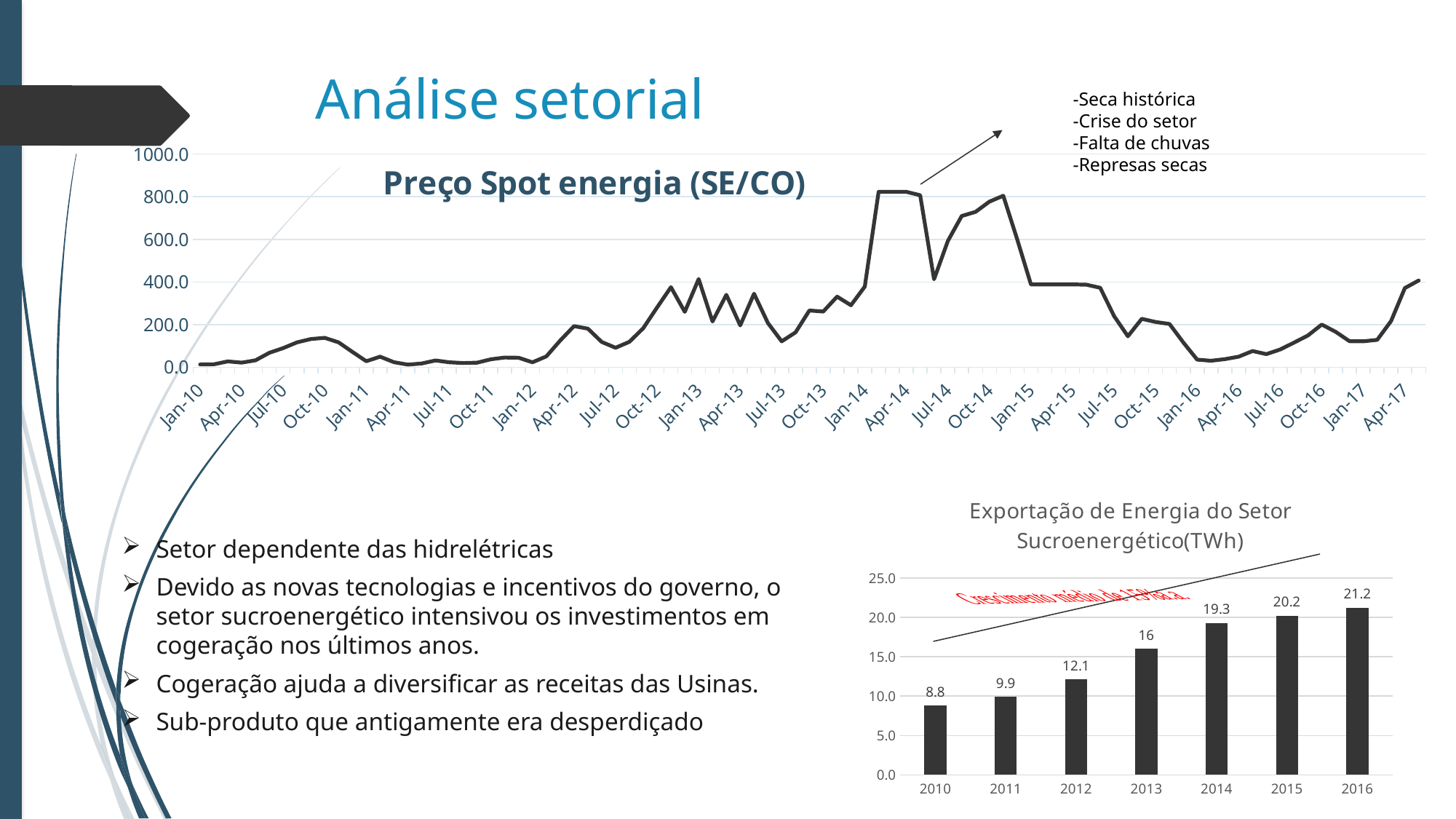
In the 'Exportação de Energia do Setor Sucroenergético(TWh)' chart, what is the value for 2013? 16 In the 'Exportação de Energia do Setor Sucroenergético(TWh)' chart, what is the value for 2010? 8.8 Do the values in the 'Exportação de Energia do Setor Sucroenergético(TWh)' chart rise or fall from 2010 to 2016? rise In the 'Exportação de Energia do Setor Sucroenergético(TWh)' chart, which year has the highest value? 2016 What kind of chart is the 'Exportação de Energia do Setor Sucroenergético(TWh)' chart? bar chart In the 'Exportação de Energia do Setor Sucroenergético(TWh)' chart, what is the difference between the values for 2016 and 2015? 1.0 In the 'Preço Spot energia (SE/CO)' chart, is the value for Apr-14 greater or less than 600.0? greater In the 'Exportação de Energia do Setor Sucroenergético(TWh)' chart, which year has the lowest value? 2010 In the 'Exportação de Energia do Setor Sucroenergético(TWh)' chart, which is larger, the value for 2012 or the value for 2011? 2012 What kind of chart is the 'Preço Spot energia (SE/CO)' chart? line chart In the 'Preço Spot energia (SE/CO)' chart, is the value for Jan-16 greater or less than 200.0? less How many bars are in the 'Exportação de Energia do Setor Sucroenergético(TWh)' chart? 7